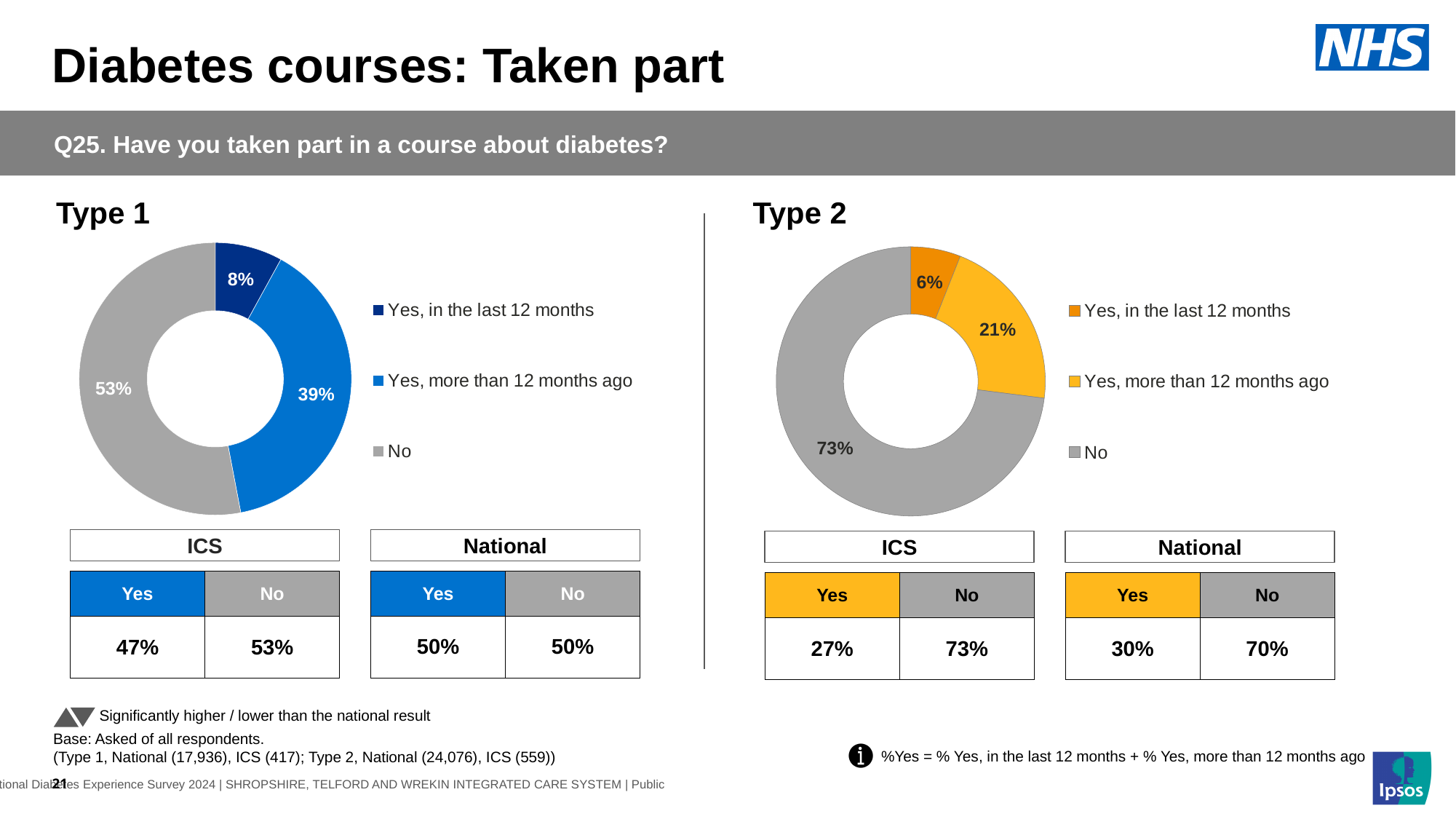
What kind of chart is used for Type 2? Doughnut chart Which is larger in the Type 2 chart: 'Yes, in the last 12 months' or 'Yes, more than 12 months ago'? Yes, more than 12 months ago In the Type 1 chart, what percentage of respondents answered 'Yes, more than 12 months ago'? 39% How many categories does the Type 1 chart show? 3 In the Type 2 chart, which category has the smallest share? Yes, in the last 12 months In the Type 1 chart, which category has the largest share? No In the Type 1 chart, what is the difference between the 'No' share and the 'Yes, more than 12 months ago' share? 14% In the Type 2 chart, what percentage of respondents answered 'No'? 73% What colour represents 'No' in the Type 2 chart? Grey In the Type 1 chart, what is the combined share of the two 'Yes' categories? 47% In the Type 2 chart, what percentage of respondents answered 'Yes, more than 12 months ago'? 21% In the Type 1 chart, what percentage of respondents answered 'Yes, in the last 12 months'? 8%